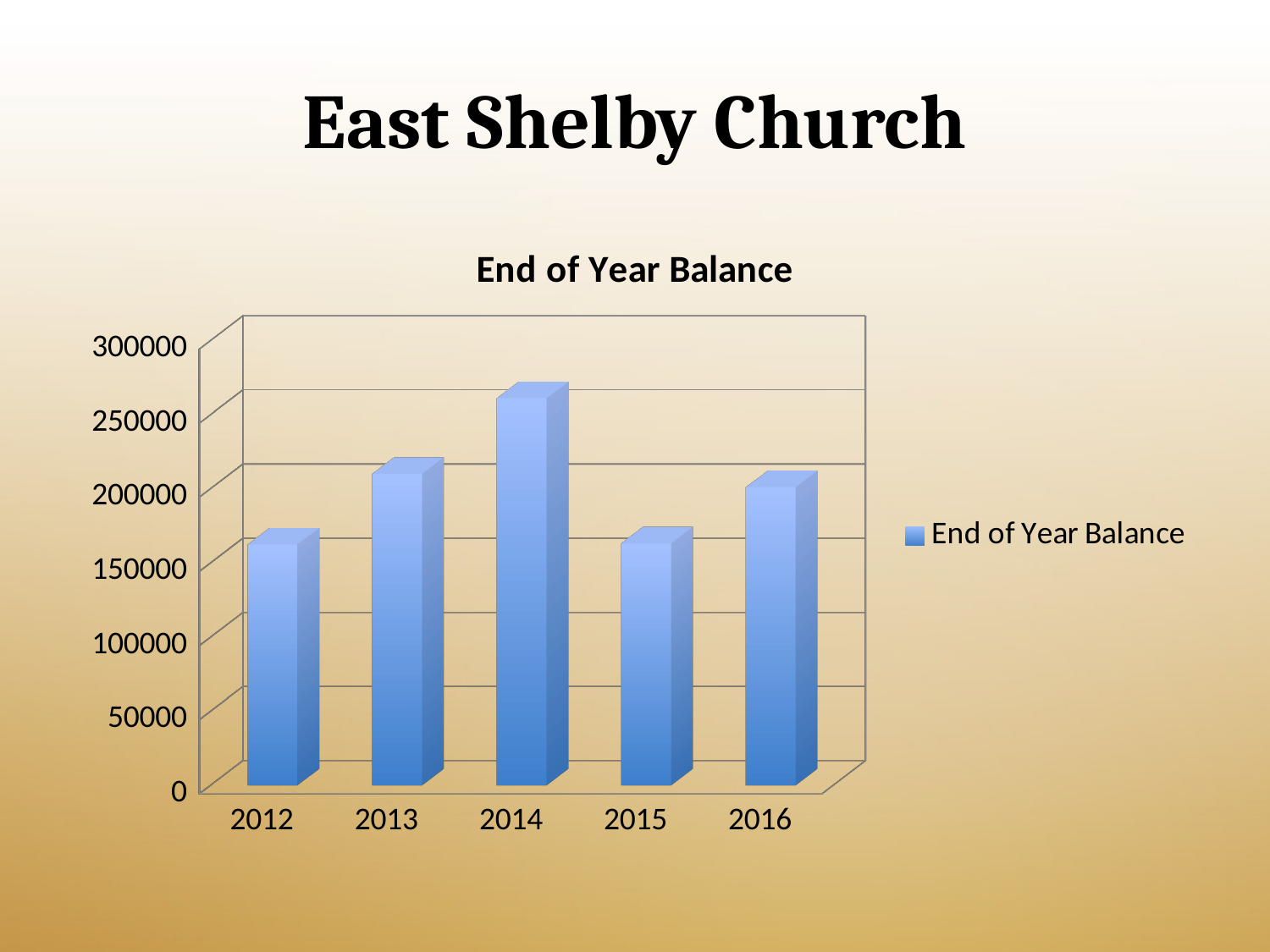
Which year has the highest End of Year Balance? 2014 Is the End of Year Balance for 2013 greater or less than 150000? greater Is the End of Year Balance for 2016 greater or less than 250000? less How many series does the legend list? 1 Which year has the larger End of Year Balance, 2013 or 2012? 2013 Does the End of Year Balance rise or fall from 2014 to 2015? fall Is the End of Year Balance for 2012 greater or less than 200000? less Which year has the larger End of Year Balance, 2015 or 2016? 2016 How many years are shown on the x axis of the chart? 5 What kind of chart is shown on the slide? bar chart What is the title of the chart? End of Year Balance